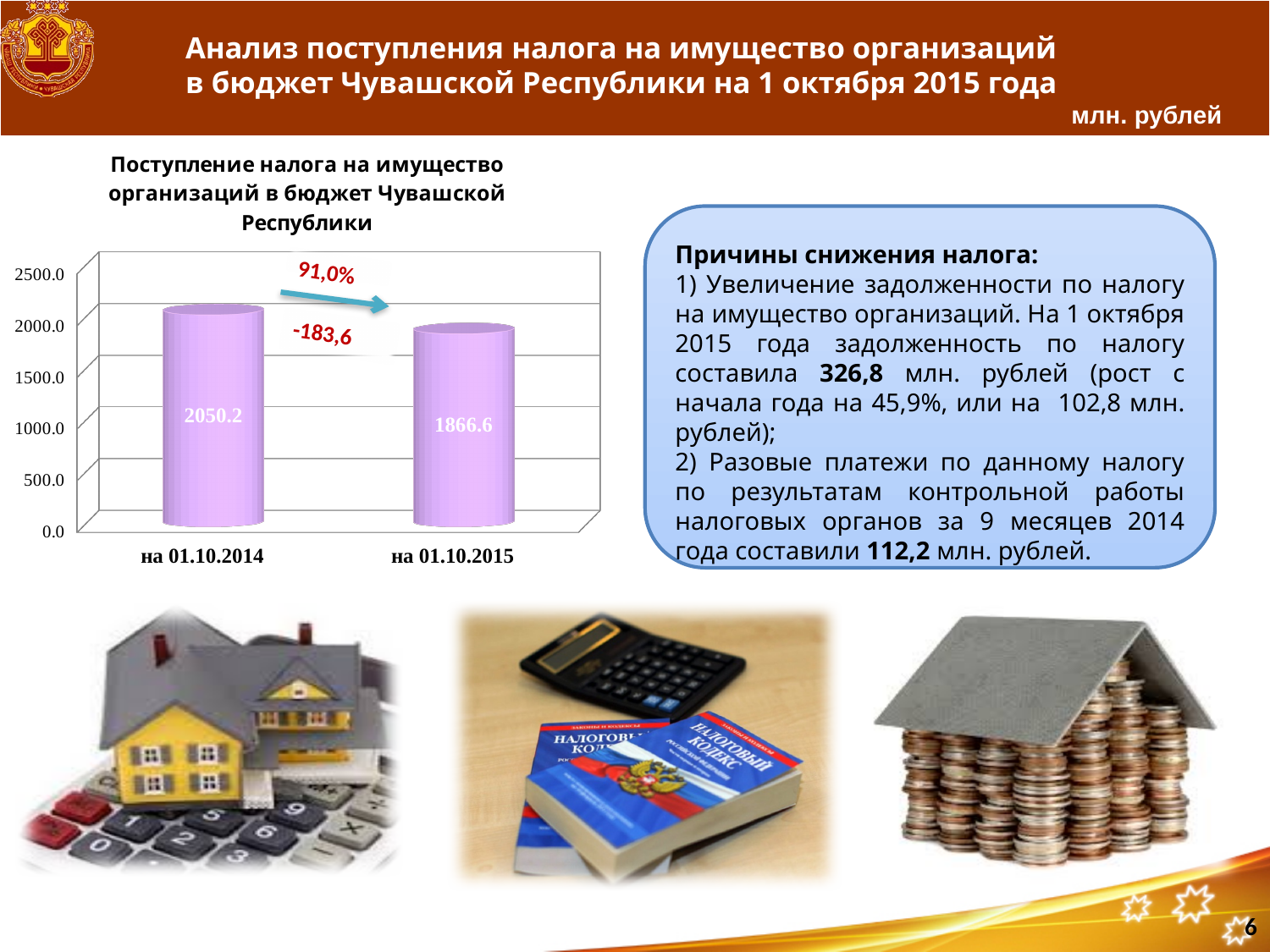
Is the value for на 01.10.2015 greater or less than 2000.0? less What is the difference between the values for на 01.10.2014 and на 01.10.2015? 183.6 What is the value for на 01.10.2015? 1866.6 What kind of chart is shown on the slide? bar chart Which category has the lowest value? на 01.10.2015 How many categories are shown on the chart? 2 Is the value for на 01.10.2014 greater or less than 2000.0? greater What is the value for на 01.10.2014? 2050.2 Which category has the highest value? на 01.10.2014 Do the values rise or fall from на 01.10.2014 to на 01.10.2015? fall What percentage is written above the arrow between the two bars? 91,0% Which is larger, the value for на 01.10.2014 or the value for на 01.10.2015? на 01.10.2014